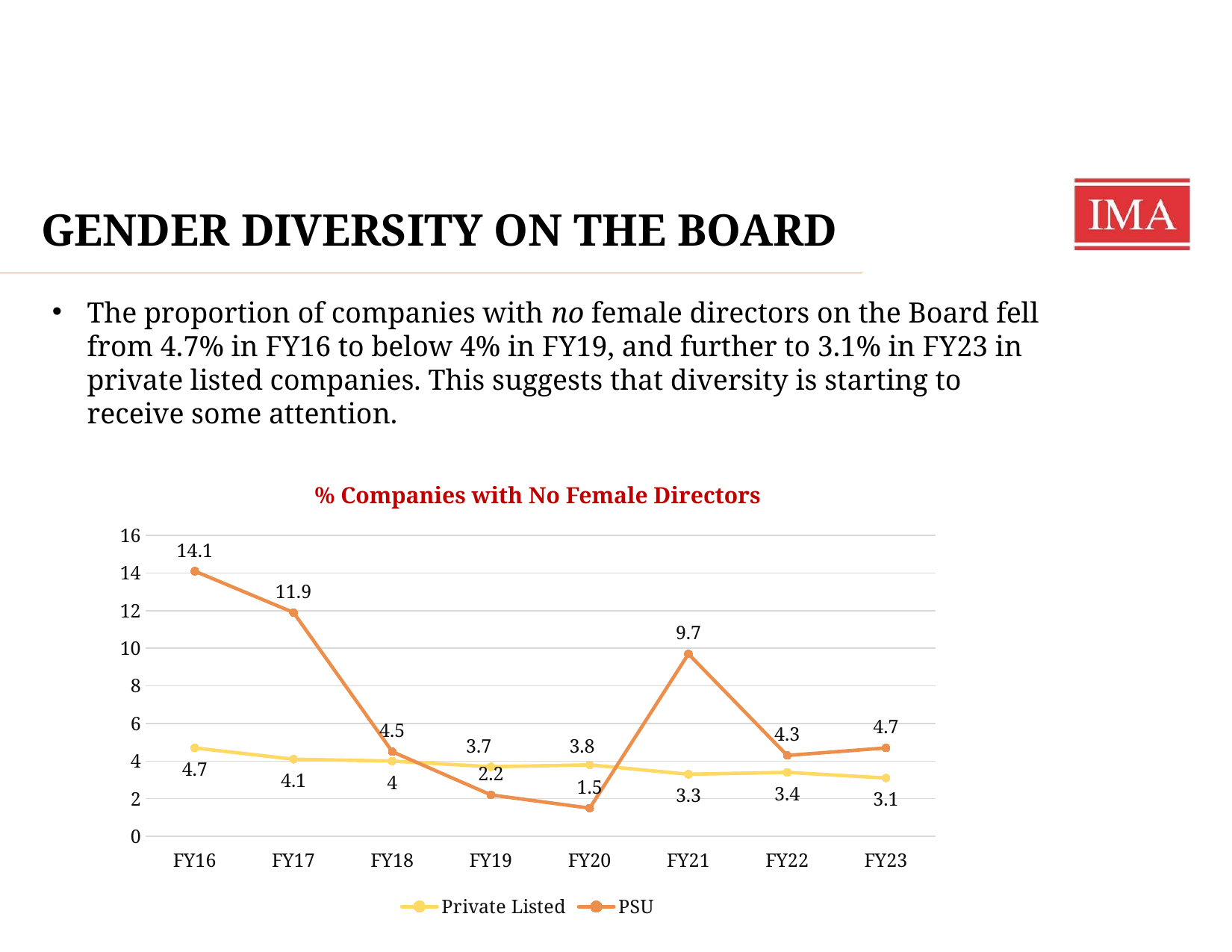
What is the difference between the PSU value and the Private Listed value in FY16? 9.4 What type of chart is shown on the slide? line chart What is the PSU value for FY16? 14.1 How many series does the legend list? 2 What is the Private Listed value for FY23? 3.1 What is the title of the chart? % Companies with No Female Directors Which series has the larger value in FY19, Private Listed or PSU? Private Listed In which fiscal year is the PSU value lowest? FY20 In which fiscal year is the Private Listed value highest? FY16 What is the PSU value for FY21? 9.7 How many fiscal years are plotted on the x axis? 8 Does the Private Listed series generally rise or fall from FY16 to FY23? fall